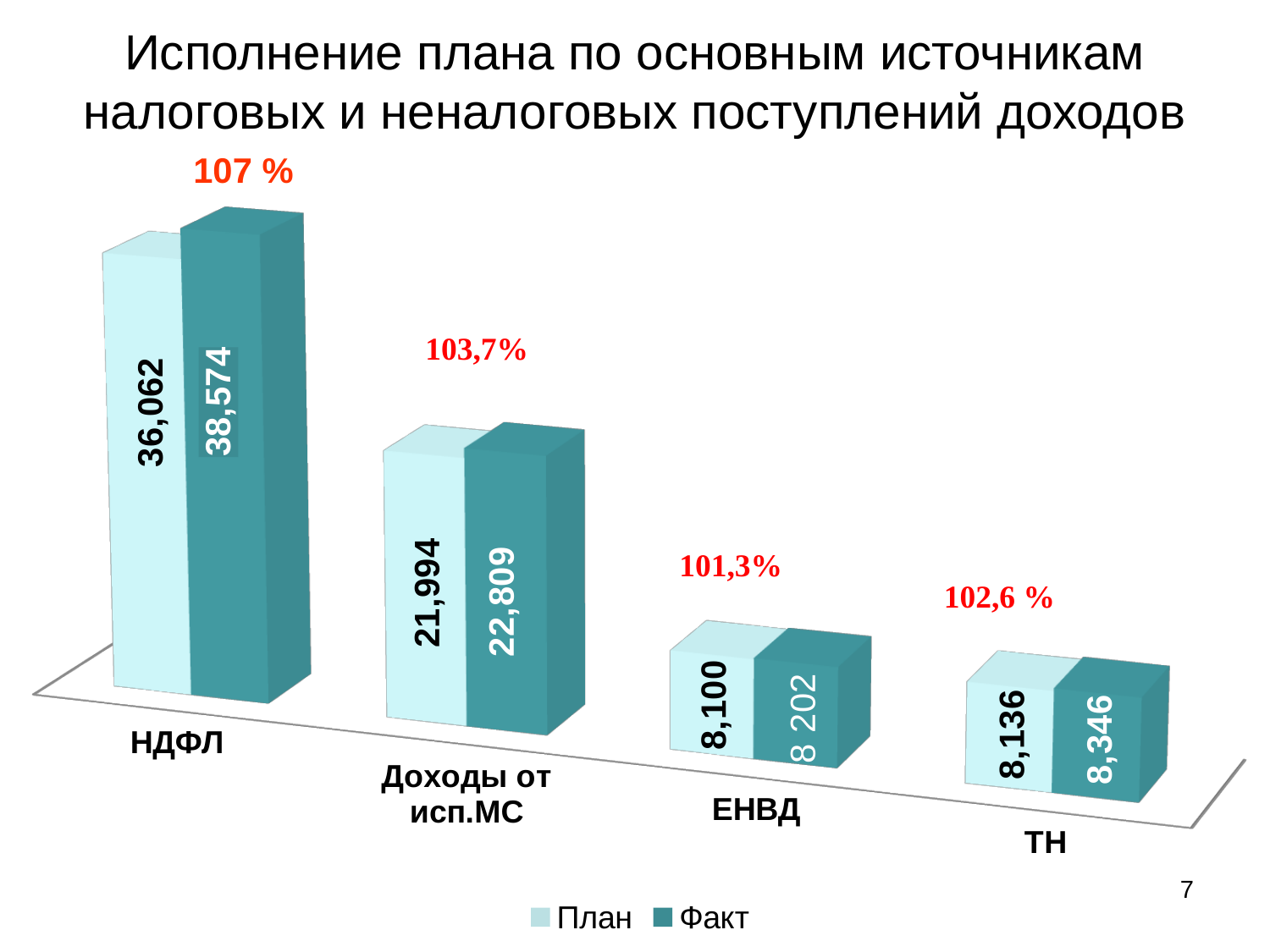
How many series does the legend list? 2 What is the План value for ТН? 8,136 Which category has the highest Факт value? НДФЛ What is the difference between the Факт and План values for Доходы от исп.МС? 815 What percentage of plan execution is shown above the ЕНВД bars? 101,3% Which category has the lowest План value? ЕНВД What is the План value for НДФЛ? 36,062 Which is larger for ТН, the План value or the Факт value? Факт What is the Факт value for НДФЛ? 38,574 What is the Факт value for Доходы от исп.МС? 22,809 What is the difference between the Факт and План values for НДФЛ? 2,512 How many categories are shown on the x axis? 4